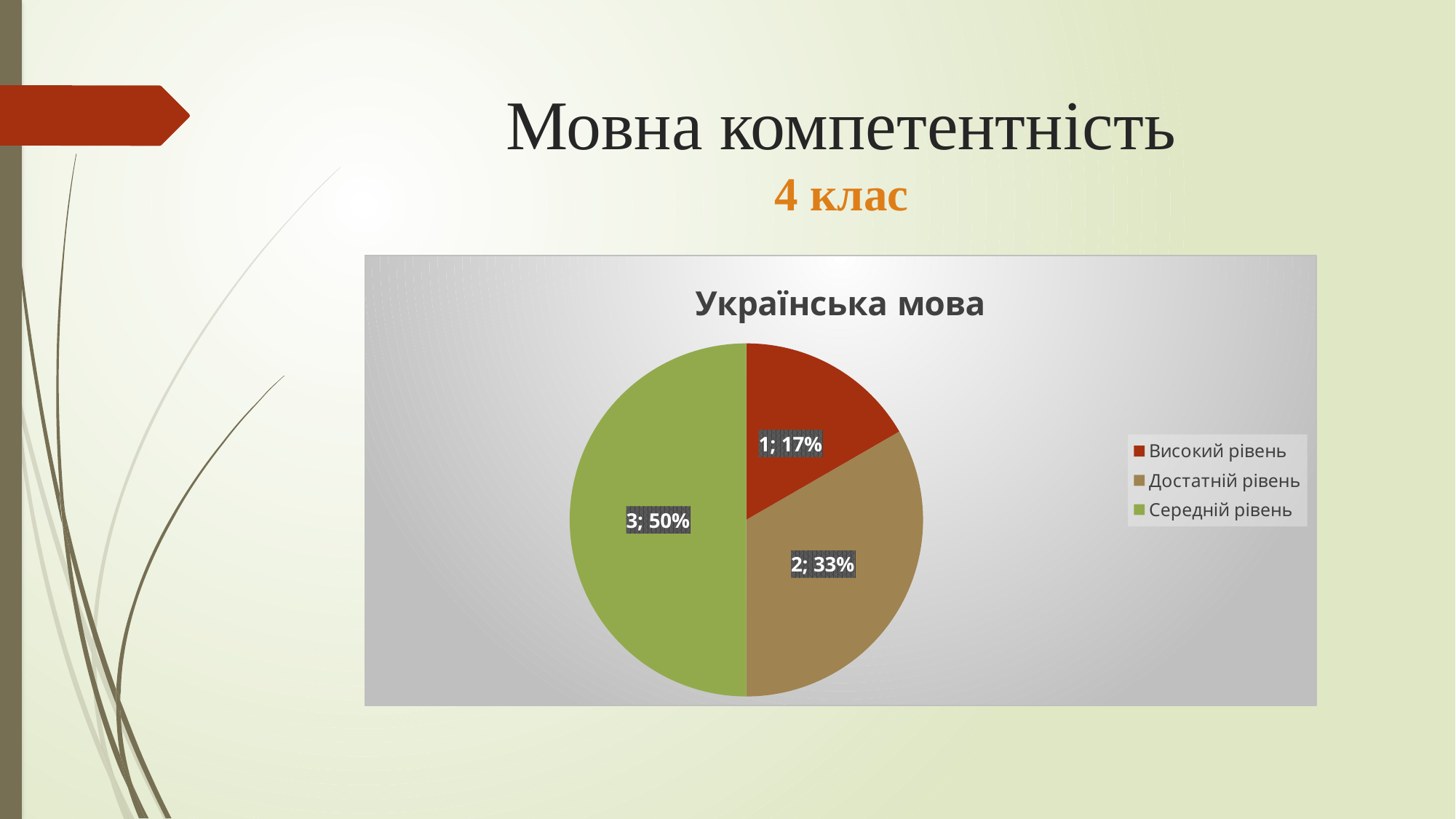
Which category has the smallest slice? Високий рівень What is the title of the chart? Українська мова What is the value shown for 'Високий рівень'? 1 What percentage share does the 'Середній рівень' slice have? 50% What percentage share does the 'Високий рівень' slice have? 17% What percentage share does the 'Достатній рівень' slice have? 33% What kind of chart is shown on the slide? pie chart How many entries does the legend list? 3 What is the difference in percentage points between 'Середній рівень' and 'Високий рівень'? 33% How many slices does the pie chart have? 3 Which category has the largest slice? Середній рівень What is the value shown for 'Середній рівень'? 3